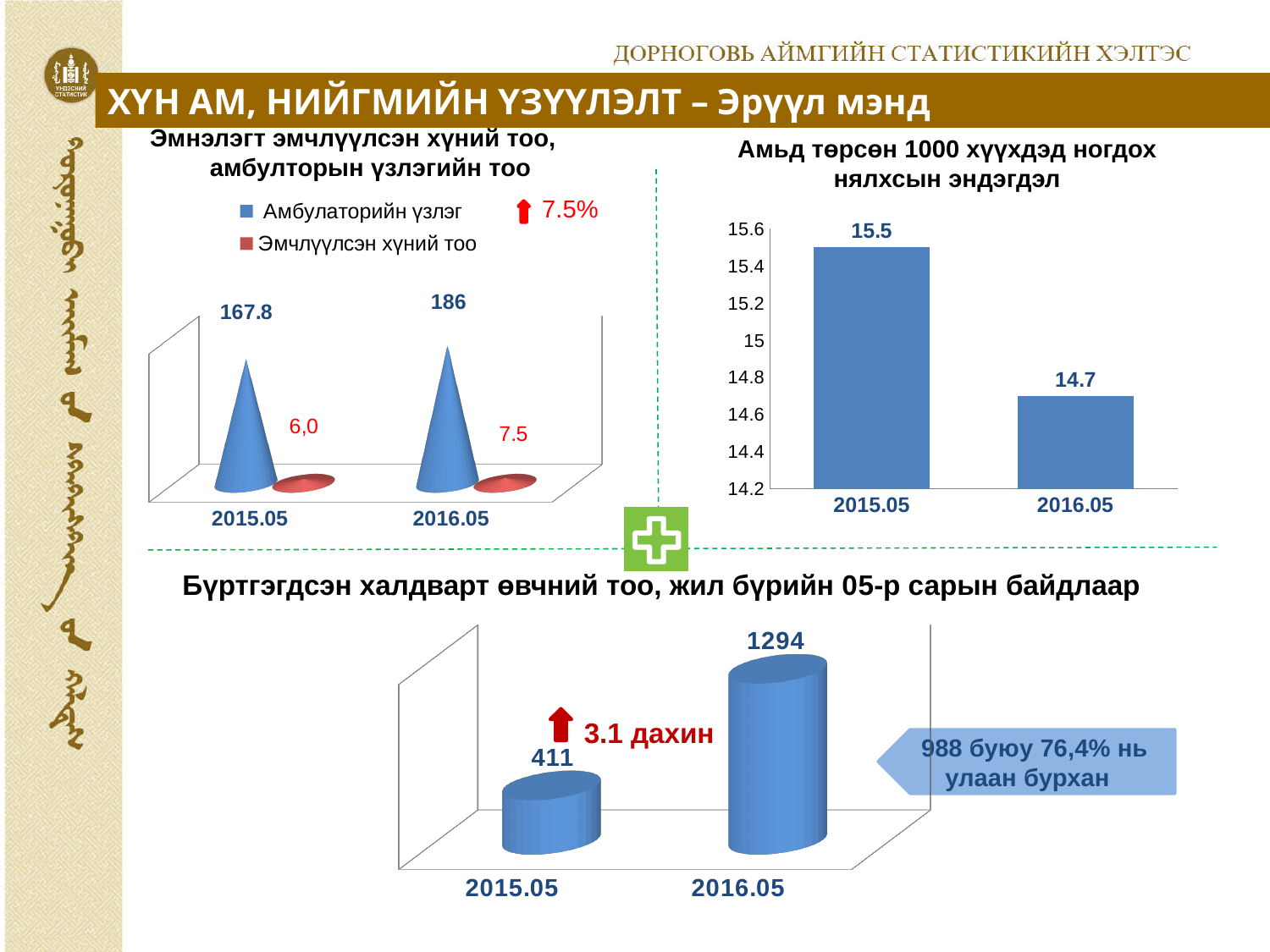
In the top-left chart 'Эмнэлэгт эмчлүүлсэн хүний тоо, амбулторын үзлэгийн тоо', what is the value of Амбулаторийн үзлэг for 2015.05? 167.8 In the bottom chart 'Бүртгэгдсэн халдварт өвчний тоо, жил бүрийн 05-р сарын байдлаар', what is the value for 2016.05? 1294 In the top-right chart 'Амьд төрсөн 1000 хүүхдэд ногдох нялхсын эндэгдэл', what is the value for 2015.05? 15.5 In the top-left chart 'Эмнэлэгт эмчлүүлсэн хүний тоо, амбулторын үзлэгийн тоо', what is the value of Эмчлүүлсэн хүний тоо for 2016.05? 7.5 In the top-right chart 'Амьд төрсөн 1000 хүүхдэд ногдох нялхсын эндэгдэл', what is the value for 2016.05? 14.7 In the top-right chart 'Амьд төрсөн 1000 хүүхдэд ногдох нялхсын эндэгдэл', what kind of chart is shown? bar chart In the top-left chart 'Эмнэлэгт эмчлүүлсэн хүний тоо, амбулторын үзлэгийн тоо', does the value of Амбулаторийн үзлэг rise or fall from 2015.05 to 2016.05? rise In the top-left chart 'Эмнэлэгт эмчлүүлсэн хүний тоо, амбулторын үзлэгийн тоо', how many series does the legend list? 2 In the top-left chart 'Эмнэлэгт эмчлүүлсэн хүний тоо, амбулторын үзлэгийн тоо', what is the value of Амбулаторийн үзлэг for 2016.05? 186 In the bottom chart 'Бүртгэгдсэн халдварт өвчний тоо, жил бүрийн 05-р сарын байдлаар', what is the difference between the 2016.05 and 2015.05 values? 883 In the top-right chart 'Амьд төрсөн 1000 хүүхдэд ногдох нялхсын эндэгдэл', what is the difference between the 2015.05 and 2016.05 values? 0.8 In the bottom chart 'Бүртгэгдсэн халдварт өвчний тоо, жил бүрийн 05-р сарын байдлаар', which period has the lower value? 2015.05